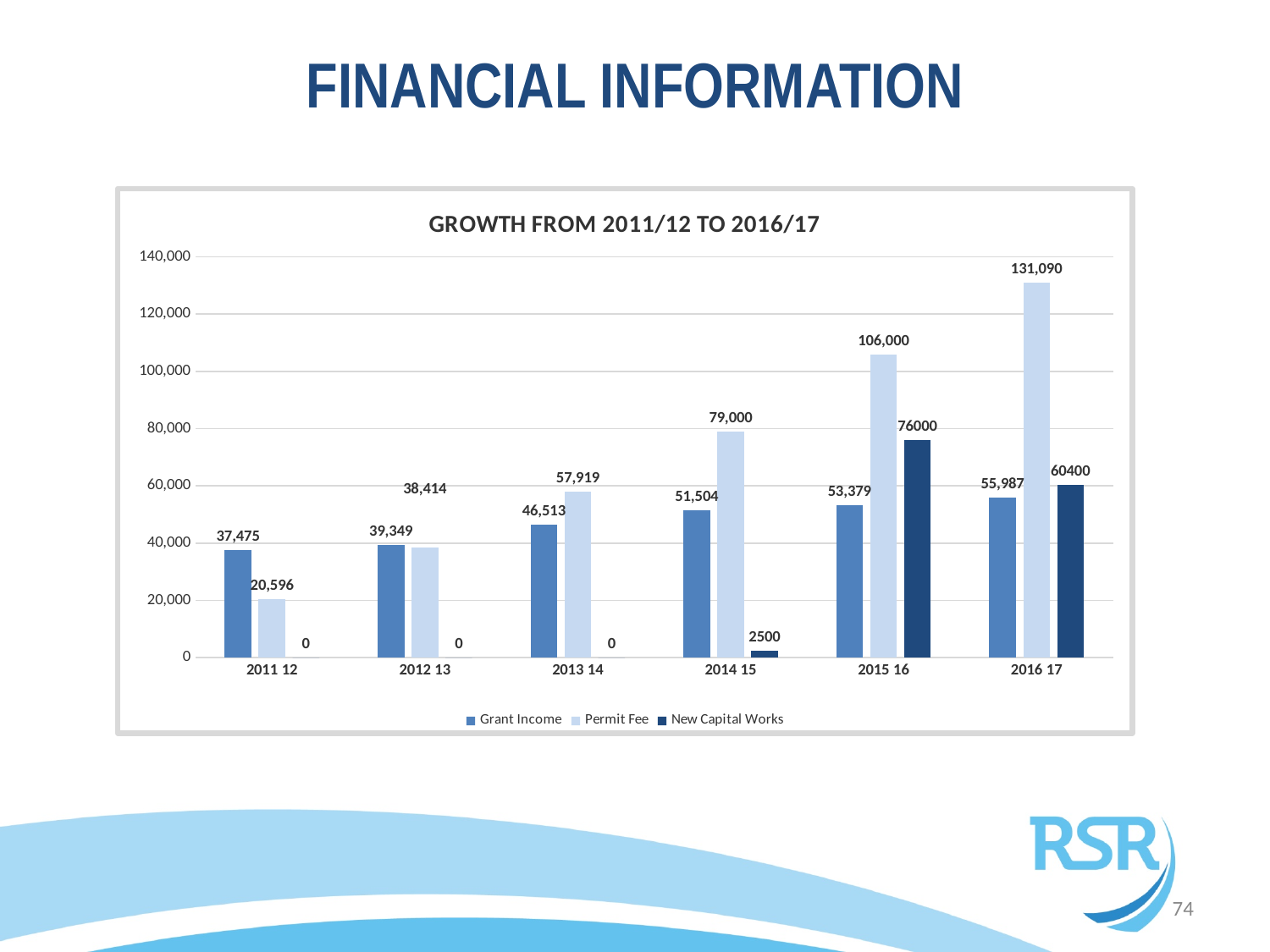
How many years are shown on the x axis? 6 What is the difference between the Permit Fee values for 2016 17 and 2015 16? 25,090 Which year has the lowest Grant Income value? 2011 12 What is the Grant Income value for 2013 14? 46,513 What kind of chart is shown? Bar chart Which is larger in 2012 13, Grant Income or Permit Fee? Grant Income What is the Permit Fee value for 2016 17? 131,090 Does the Permit Fee value rise or fall from 2011 12 to 2016 17? Rise How many series does the legend list? 3 What is the New Capital Works value for 2015 16? 76000 Which year has the highest Permit Fee value? 2016 17 What is the title of the chart? GROWTH FROM 2011/12 TO 2016/17